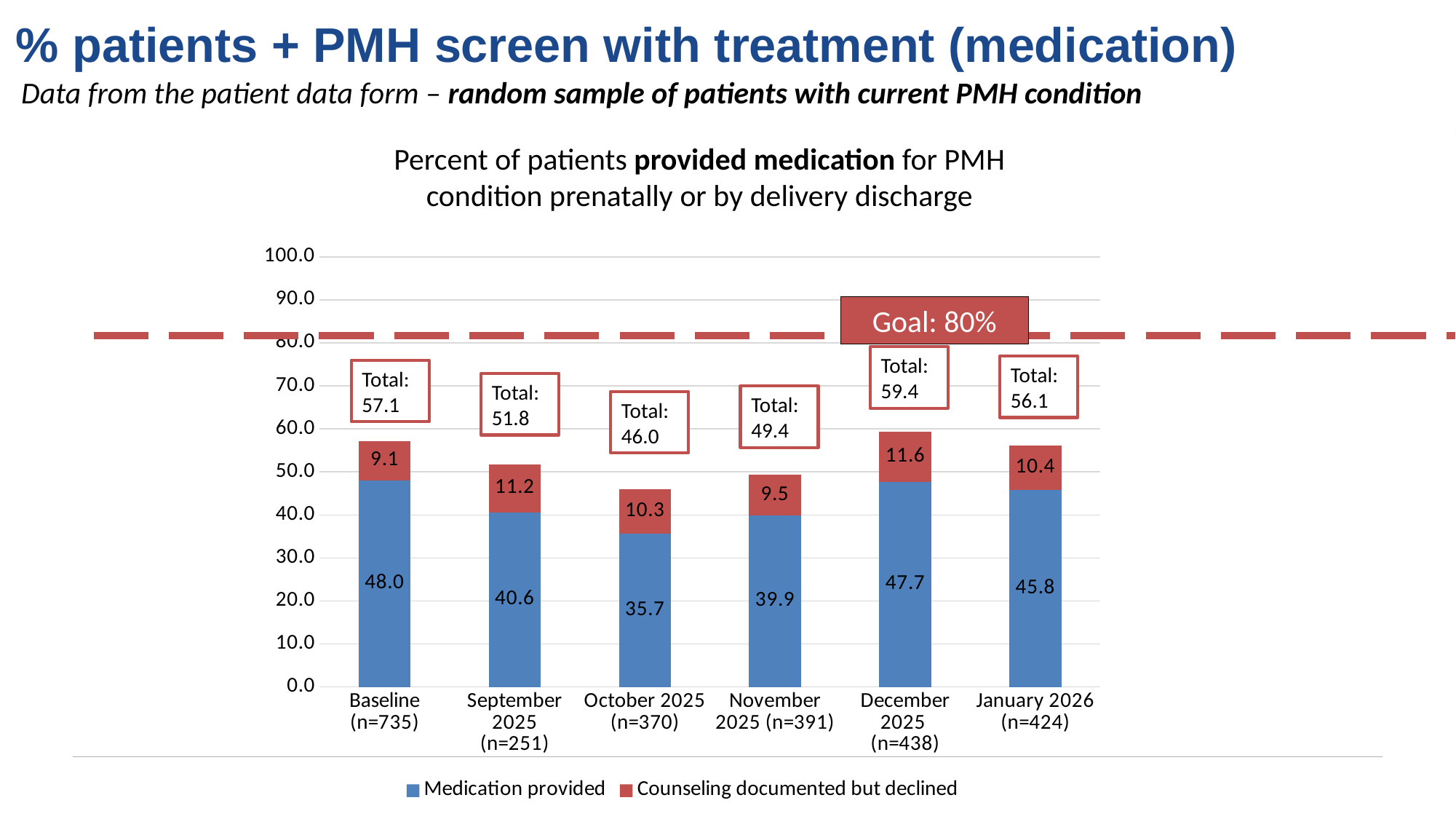
What goal value is marked by the dashed line on the chart? 80% What is the value for Medication provided in October 2025 (n=370)? 35.7 How many categories are shown on the x axis? 6 Which category has the highest Medication provided value? Baseline (n=735) How many series does the legend list? 2 What is the value for Medication provided at Baseline (n=735)? 48.0 What is the value for Counseling documented but declined in December 2025 (n=438)? 11.6 Is the total for October 2025 (n=370) greater or less than 50.0? less What is the total of the stacked bar for December 2025 (n=438)? 59.4 Which category has the lowest Medication provided value? October 2025 (n=370) Which is larger: the Counseling documented but declined value for September 2025 (n=251) or for November 2025 (n=391)? September 2025 (n=251) What is the difference between the Medication provided values for Baseline (n=735) and January 2026 (n=424)? 2.2